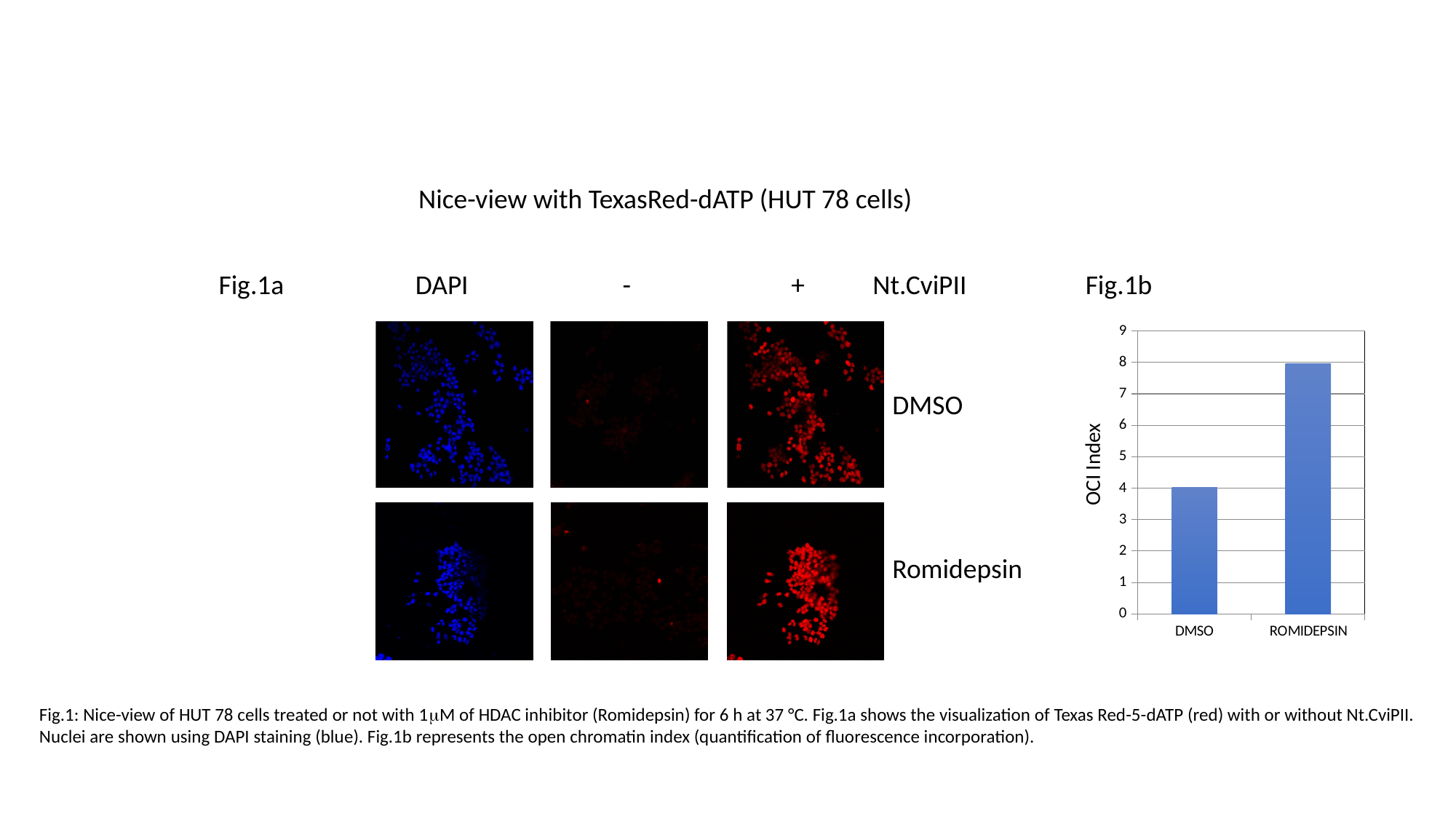
In Fig.1b, is the OCI Index for ROMIDEPSIN greater or less than 9? less What is the maximum value shown on the y axis of Fig.1b? 9 In Fig.1b, which category has the lowest OCI Index? DMSO In Fig.1b, is the OCI Index for DMSO greater or less than 5? less In Fig.1b, is the OCI Index for ROMIDEPSIN greater or less than 6? greater In Fig.1b, how many categories are plotted on the x axis? 2 What is the label of the y axis in Fig.1b? OCI Index What kind of chart is Fig.1b? bar chart In Fig.1b, which has a larger OCI Index, DMSO or ROMIDEPSIN? ROMIDEPSIN In Fig.1b, which category has the highest OCI Index? ROMIDEPSIN